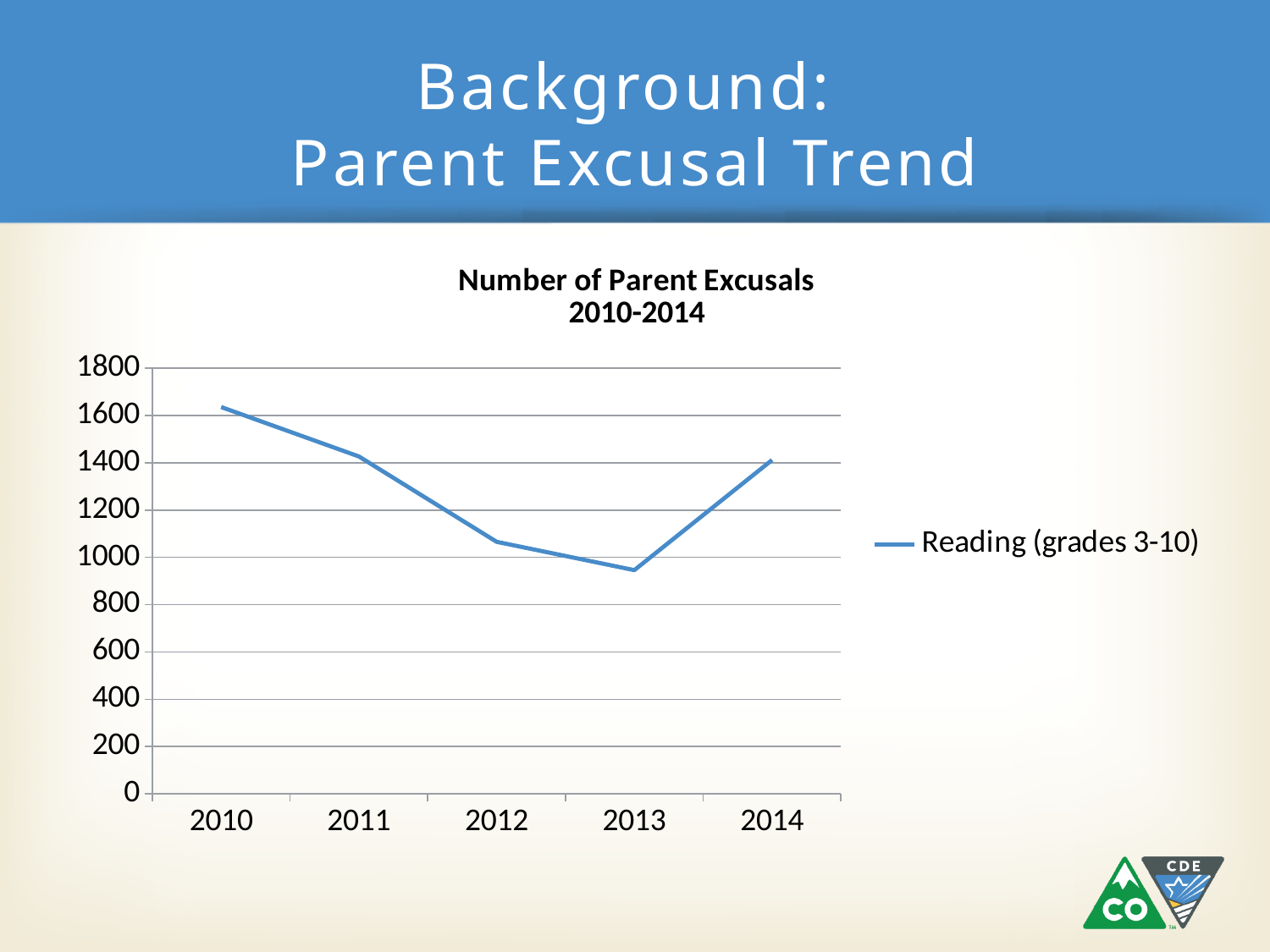
Which year has the lowest number of parent excusals? 2013 Which year has the highest number of parent excusals? 2010 What is the title of the chart? Number of Parent Excusals 2010-2014 Do the number of parent excusals rise or fall from 2010 to 2013? fall Is the value for 2010 greater or less than 1600? greater What kind of chart is shown on the slide? line chart Is the value for 2013 greater or less than 1000? less Is the value for 2014 greater or less than 1200? greater What series name appears in the legend? Reading (grades 3-10) How many series does the legend list? 1 How many years are plotted on the x axis? 5 Which year has more parent excusals, 2010 or 2014? 2010